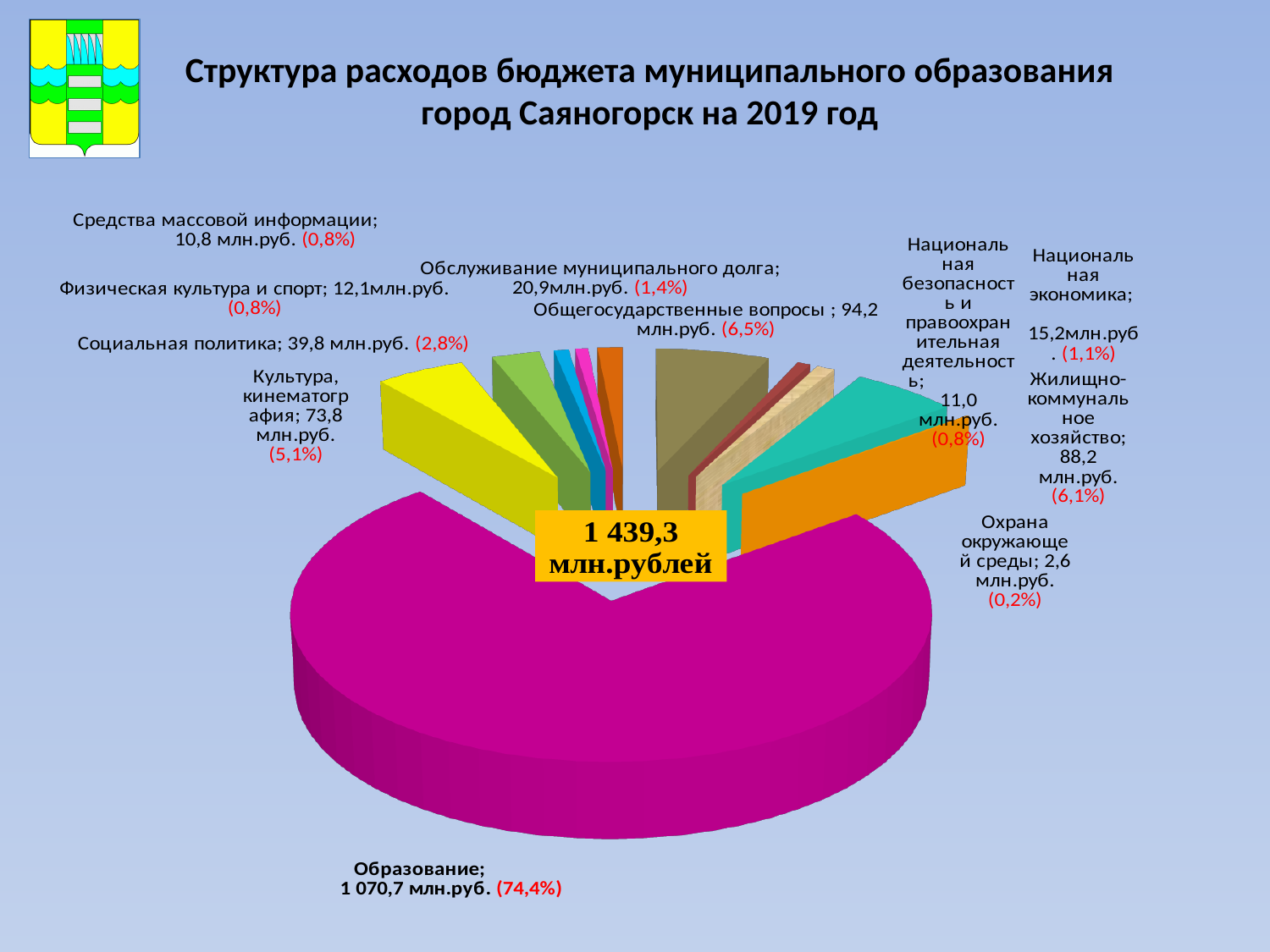
Какой тип диаграммы показан на слайде? Круговая диаграмма Что больше: расходы на Общегосударственные вопросы или на Жилищно-коммунальное хозяйство? Общегосударственные вопросы Сколько млн.руб. приходится на Образование? 1 070,7 млн.руб. Сколько млн.руб. выделено на Социальную политику? 39,8 млн.руб. Какая доля расходов приходится на Жилищно-коммунальное хозяйство? 6,1% Какая категория расходов является наименьшей? Охрана окружающей среды Какова общая сумма расходов бюджета, указанная в центре диаграммы? 1 439,3 млн.рублей На сколько млн.руб. расходы на Культуру, кинематографию превышают расходы на Социальную политику? 34 млн.руб. Сколько категорий расходов показано на диаграмме? 11 Какая доля расходов приходится на Обслуживание муниципального долга? 1,4% Каким цветом показан сектор Образование? Малиновым (пурпурным) Какая категория расходов является наибольшей? Образование